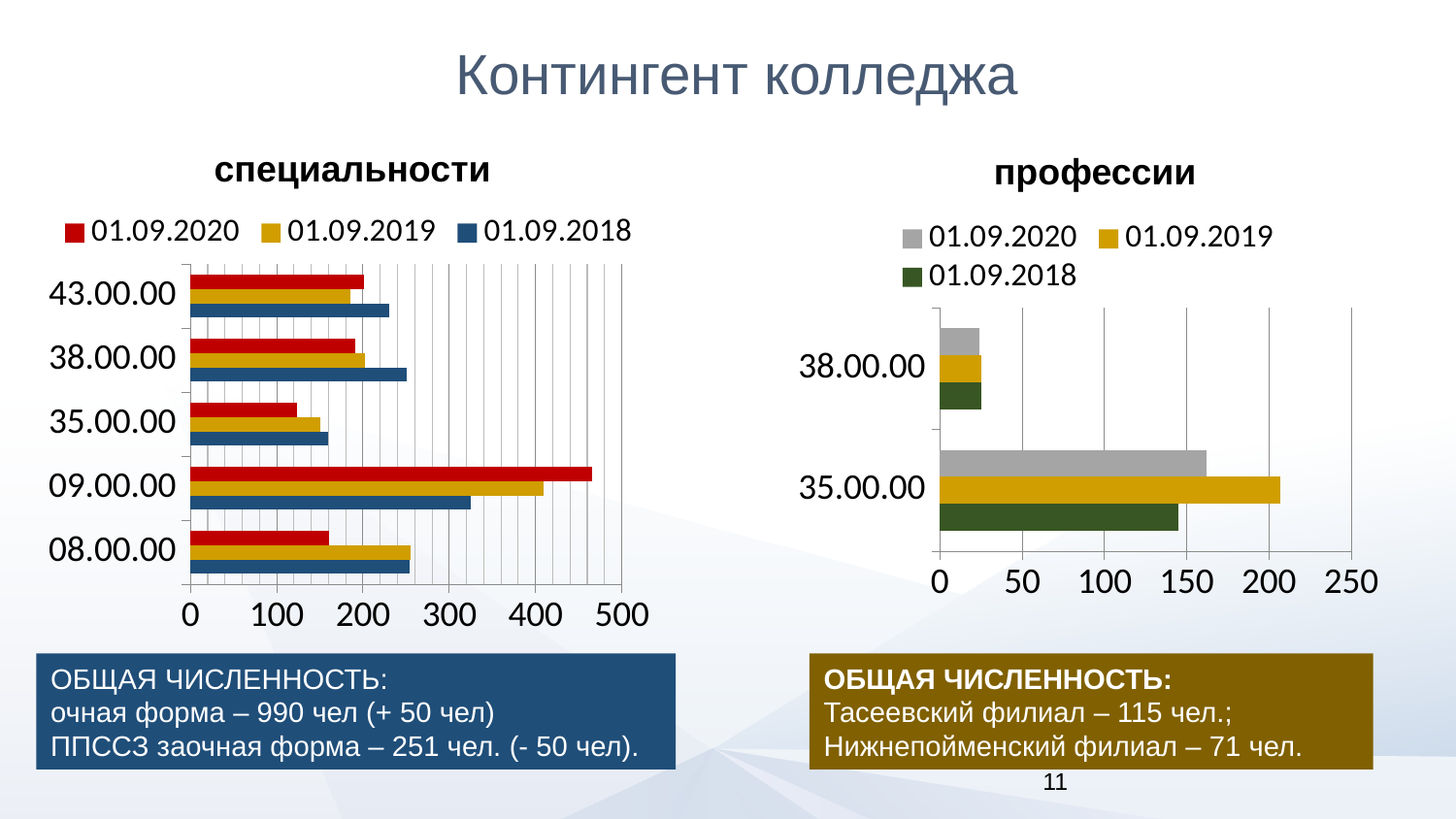
How many categories are shown on the "профессии" chart? 2 What kind of chart is the "специальности" chart on the left? bar chart How many series does the legend of the "профессии" chart list? 3 On the "специальности" chart, is the value for 09.00.00 on 01.09.2020 greater or less than 400? greater On the "специальности" chart, for category 09.00.00, which is larger: the value for 01.09.2020 or for 01.09.2018? 01.09.2020 On the "профессии" chart, is the value for 38.00.00 on 01.09.2020 greater or less than 50? less How many series does the legend of the "специальности" chart list? 3 On the "специальности" chart, is the value for 35.00.00 on 01.09.2020 greater or less than 200? less On the "специальности" chart, which category has the highest value for 01.09.2020? 09.00.00 On the "профессии" chart, which series has the highest value for 35.00.00? 01.09.2019 On the "специальности" chart, what colour represents the 01.09.2020 series? red How many categories are shown on the "специальности" chart? 5